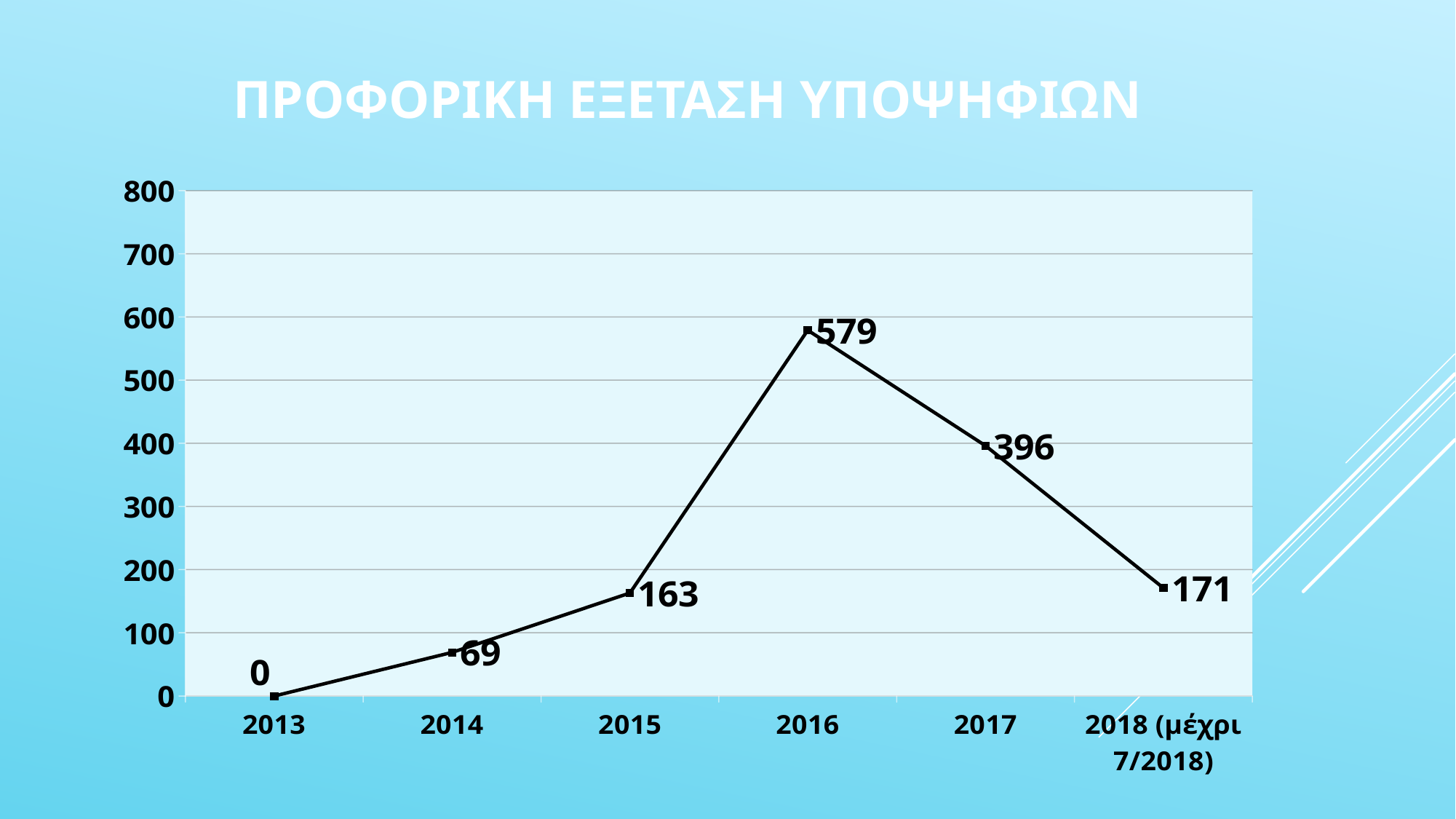
Which is larger, the value for 2017 or the value for 2018 (μέχρι 7/2018)? 2017 What is the value for 2016? 579 What is the difference between the values for 2016 and 2017? 183 Which year has the highest value? 2016 Which year has the lowest value? 2013 What kind of chart is shown on the slide? line chart What is the value for 2014? 69 What is the value for 2018 (μέχρι 7/2018)? 171 What is the title of the chart? ΠΡΟΦΟΡΙΚΗ ΕΞΕΤΑΣΗ ΥΠΟΨΗΦΙΩΝ How many data points are plotted on the chart? 6 Do the values rise or fall from 2016 to 2018 (μέχρι 7/2018)? fall What is the difference between the values for 2015 and 2014? 94